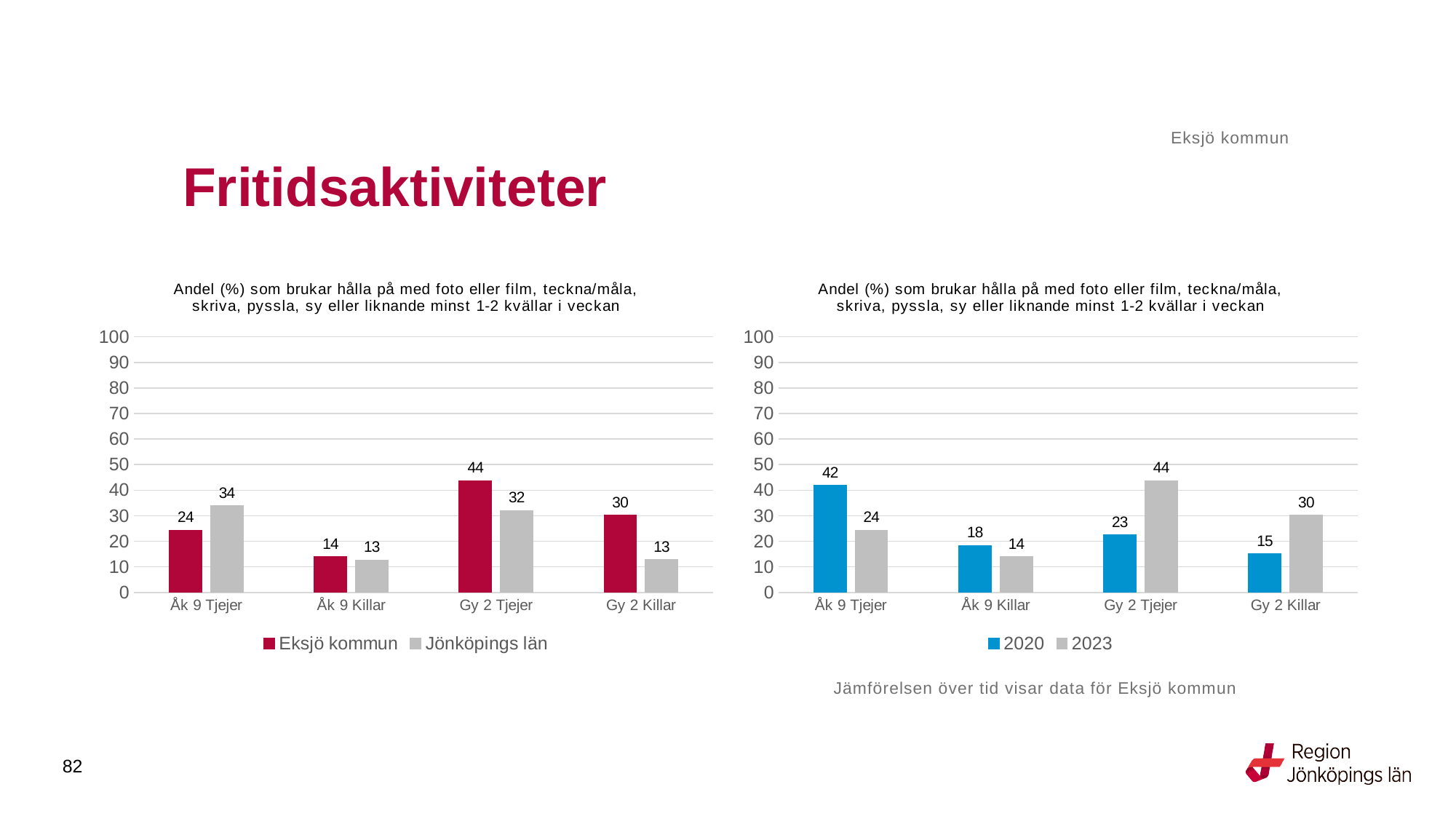
In the right chart, what is the value for 2020 for Åk 9 Tjejer? 42 How many series does the legend of the right chart list? 2 In the right chart, what is the value for 2023 for Gy 2 Killar? 30 In the left chart, what is the value for Eksjö kommun for Gy 2 Tjejer? 44 In the left chart, what is the difference between Eksjö kommun and Jönköpings län for Gy 2 Killar? 17 In the right chart, which is larger for Åk 9 Killar: 2020 or 2023? 2020 In the left chart, what is the value for Jönköpings län for Åk 9 Tjejer? 34 In the right chart, what is the difference between 2020 and 2023 for Gy 2 Tjejer? 21 How many categories are shown on the x axis of the left chart? 4 In the left chart, which category has the highest value for Eksjö kommun? Gy 2 Tjejer What kind of chart is the left chart? Bar chart In the right chart, which category has the lowest value for 2020? Gy 2 Killar